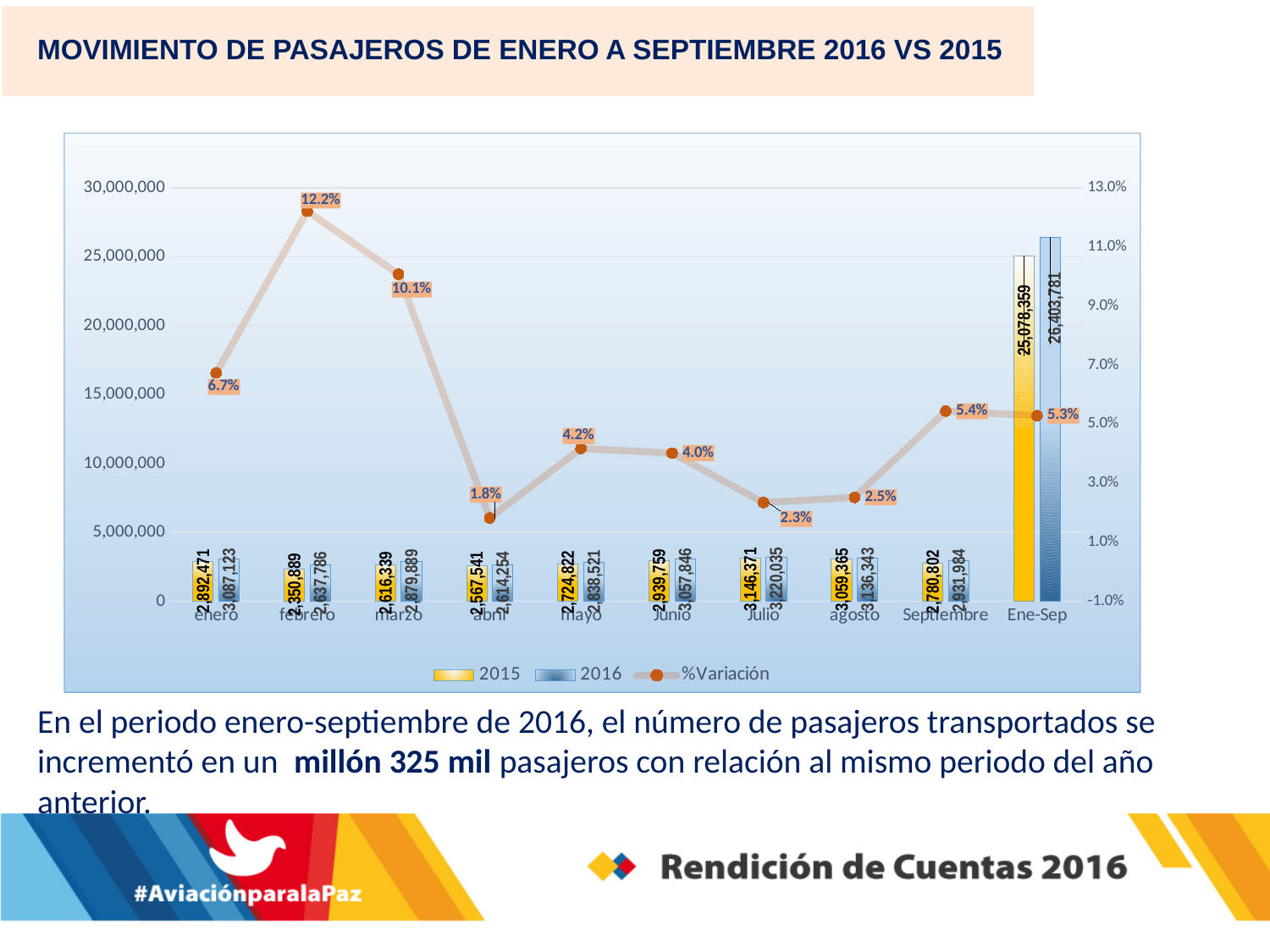
What is the %Variación value for marzo? 10.1% Among the individual months, which has the lowest 2015 value? febrero What is the difference between the 2016 and 2015 values for Ene-Sep? 1,325,422 What is the 2015 value for julio? 3,146,371 Which category has the highest %Variación? febrero What is the 2016 value for Ene-Sep? 26,403,781 Which category has the lowest %Variación? abril Does the %Variación line rise or fall from febrero to abril? Fall How many categories are shown on the x axis? 10 What kind of chart is this? Combined bar and line chart How many series does the legend list? 3 Which is larger, the 2016 value for julio or the 2016 value for agosto? julio